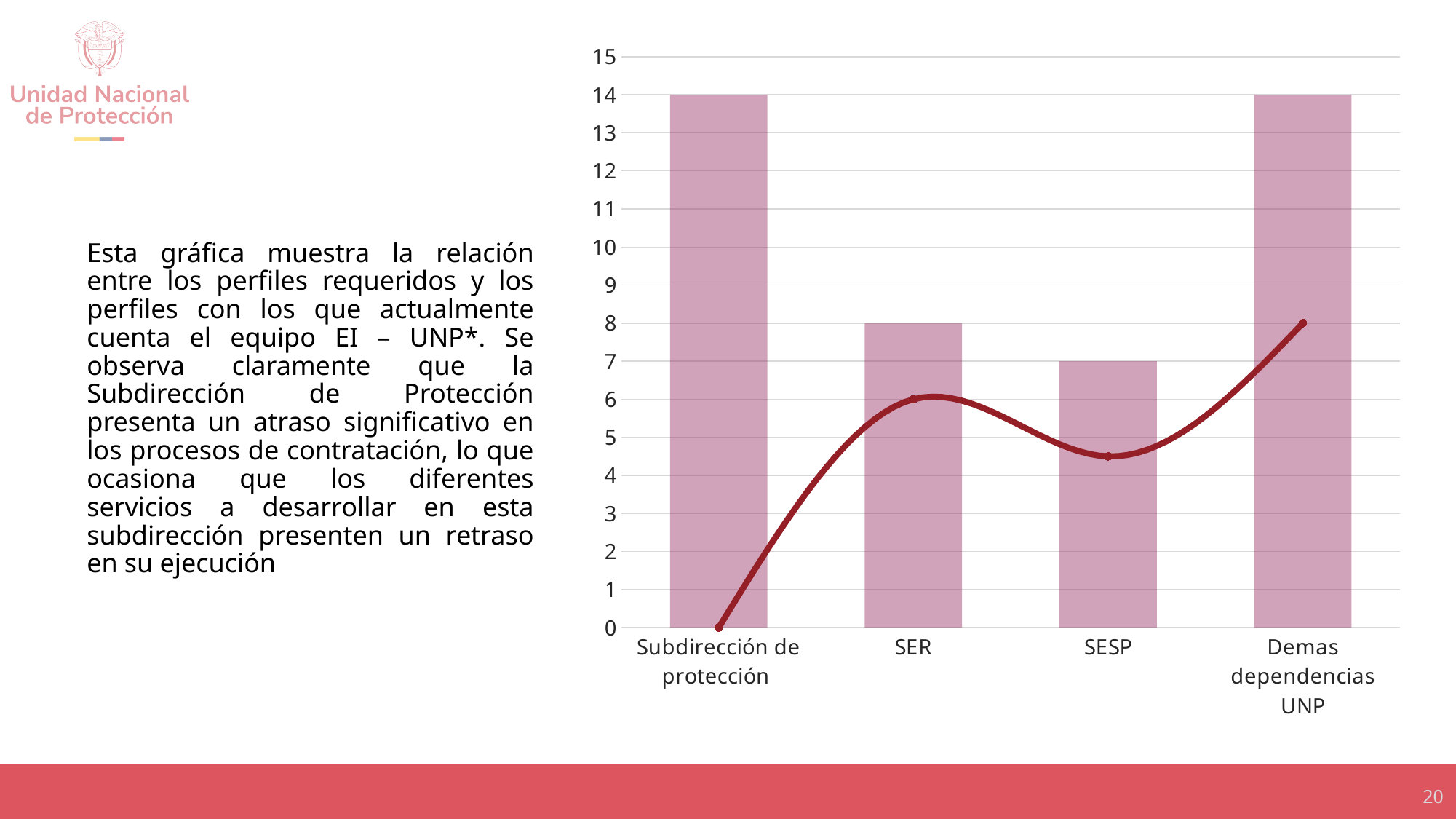
What is the value of the line point for SER? 6 What is the value of the line point for Demas dependencias UNP? 8 Which category has the lowest line point? Subdirección de protección Is the line point for SESP greater or less than 5? less Which is larger, the bar for SER or the bar for SESP? SER How many categories are shown on the x axis? 4 What is the value of the bar for SER? 8 What is the value of the bar for SESP? 7 Which category has the highest line point? Demas dependencias UNP What is the value of the bar for Subdirección de protección? 14 What is the difference between the bar value and the line value for Subdirección de protección? 14 Which category has the lowest bar? SESP